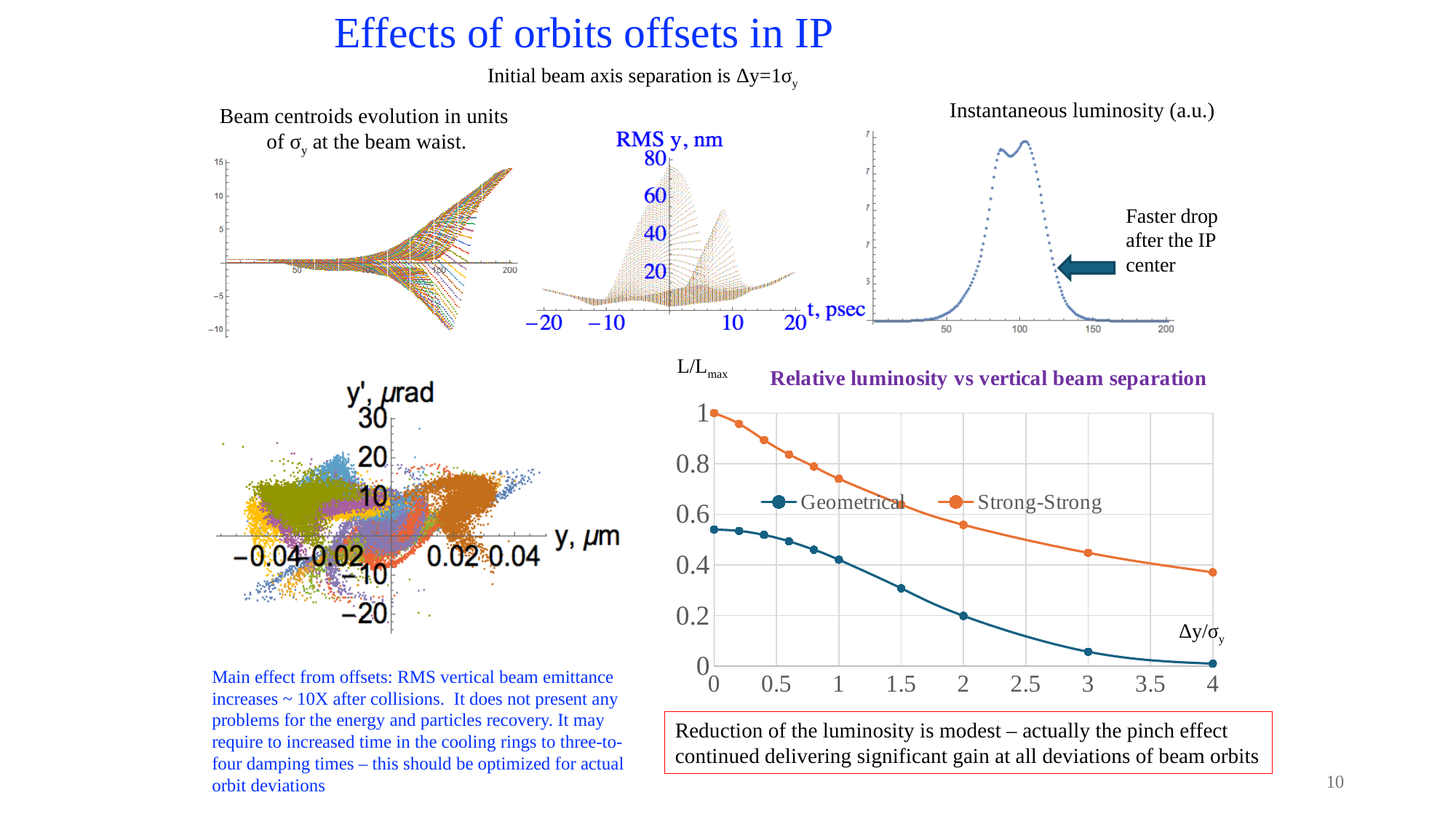
In the 'Relative luminosity vs vertical beam separation' chart, is the Geometrical value at Δy/σy = 0 greater or less than 0.6? less In the 'Relative luminosity vs vertical beam separation' chart, what is the Strong-Strong value at Δy/σy = 0? 1 In the 'Relative luminosity vs vertical beam separation' chart, what are the two series named in the legend? Geometrical and Strong-Strong In the 'Relative luminosity vs vertical beam separation' chart, how many series does the legend list? 2 In the 'Relative luminosity vs vertical beam separation' chart, is the Strong-Strong value at Δy/σy = 1 greater or less than 0.8? less In the 'RMS y, nm' chart, is the highest value reached greater or less than 60? greater In the 'Relative luminosity vs vertical beam separation' chart, what is the label on the vertical axis? L/Lmax In the 'Relative luminosity vs vertical beam separation' chart, how many data points are plotted for the Strong-Strong series? 10 In the 'Relative luminosity vs vertical beam separation' chart, which series has the larger value at Δy/σy = 2, Geometrical or Strong-Strong? Strong-Strong In the 'Relative luminosity vs vertical beam separation' chart, do the Geometrical values rise or fall as Δy/σy increases? Fall What kind of chart is the 'Relative luminosity vs vertical beam separation' chart? Line chart